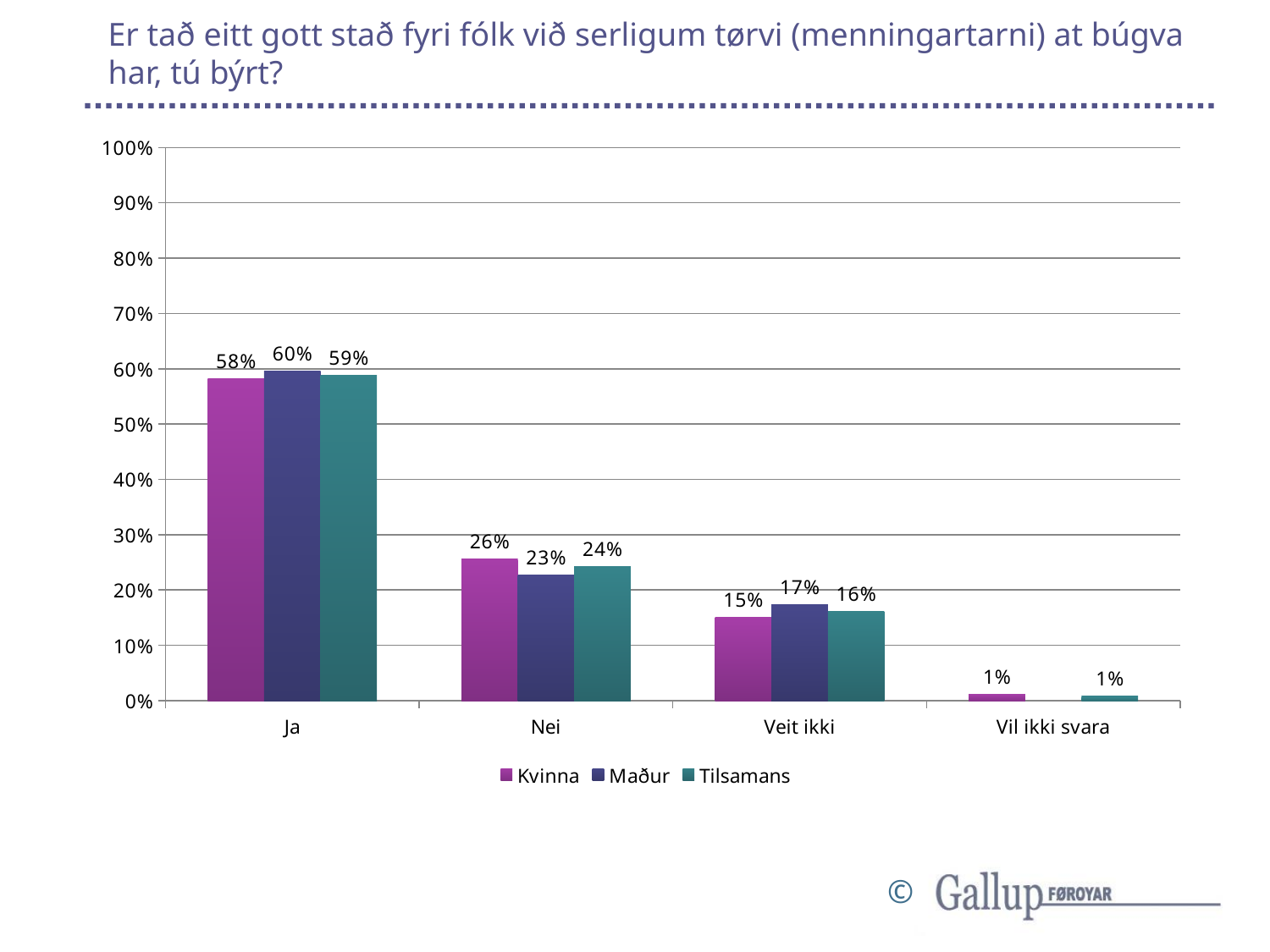
What is the difference between the Kvinna and Maður values in the Nei category? 3% In the Veit ikki category, which is larger: the Kvinna value or the Maður value? Maður What is the value for Maður in the Nei category? 23% Which category has the lowest value for the Kvinna series? Vil ikki svara Which series is shown in the teal colour in the legend? Tilsamans What is the value for Tilsamans in the Veit ikki category? 16% How many categories are shown on the x axis? 4 What kind of chart is shown on the slide? Bar chart How many series does the legend list? 3 What is the value for Kvinna in the Vil ikki svara category? 1% What is the value for Kvinna in the Ja category? 58% Which category has the highest value for the Tilsamans series? Ja